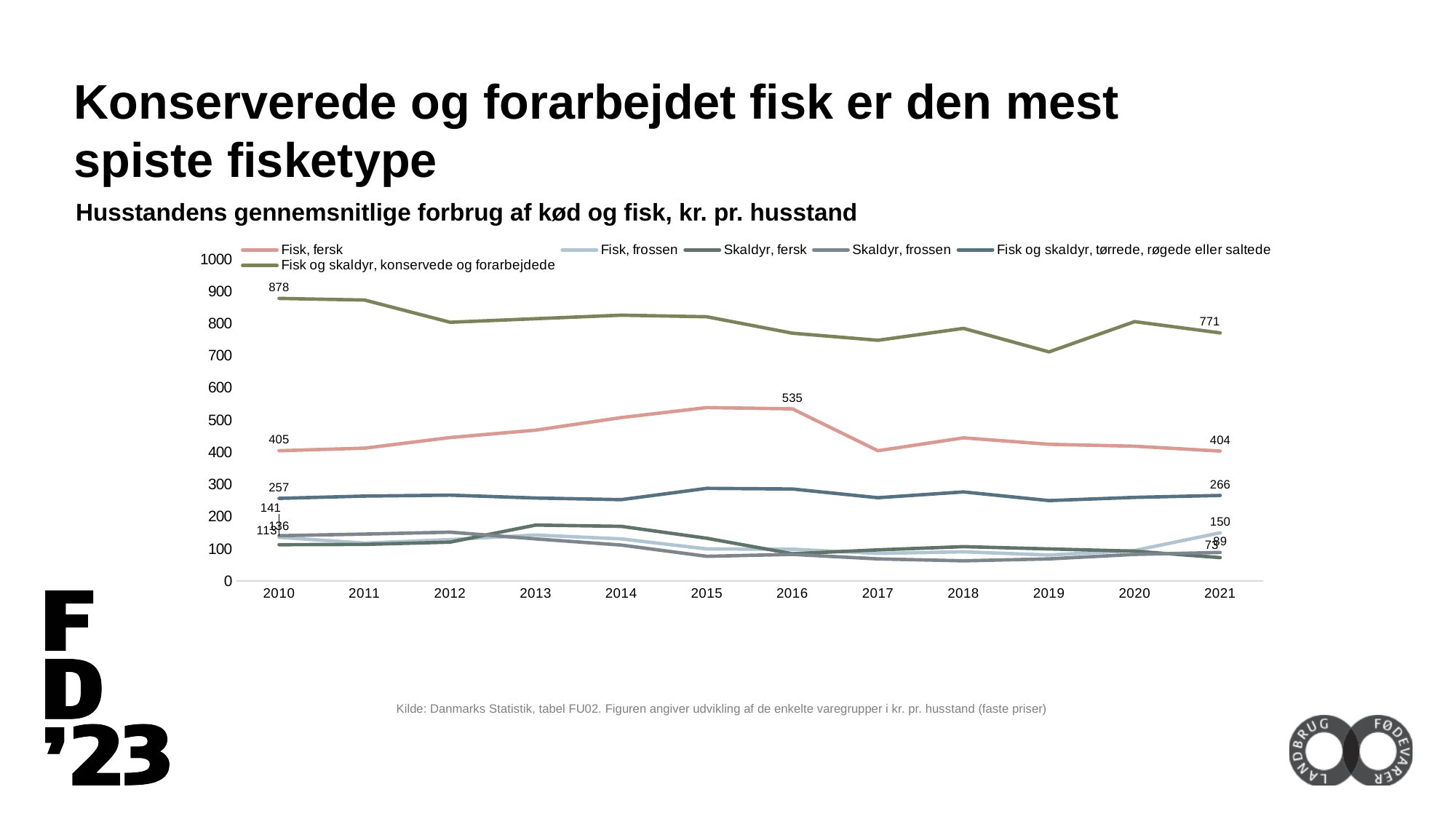
What is the difference between the 'Fisk, fersk' value in 2016 and in 2021? 131 What is the value for 'Fisk og skaldyr, konservede og forarbejdede' in 2010? 878 How many series does the legend list? 6 Which series has the highest value in 2021? Fisk og skaldyr, konservede og forarbejdede Is the value for 'Fisk og skaldyr, konservede og forarbejdede' in 2019 greater or less than 800? less What type of chart is shown on the slide? line chart Which is larger: 'Fisk, fersk' in 2010 or 'Fisk og skaldyr, tørrede, røgede eller saltede' in 2010? Fisk, fersk By how much did 'Fisk og skaldyr, konservede og forarbejdede' fall from 2010 to 2021? 107 What is the value for 'Fisk, fersk' in 2016? 535 What is the value for 'Fisk og skaldyr, tørrede, røgede eller saltede' in 2021? 266 How many years are shown on the x axis? 12 What is the value for 'Fisk og skaldyr, konservede og forarbejdede' in 2021? 771